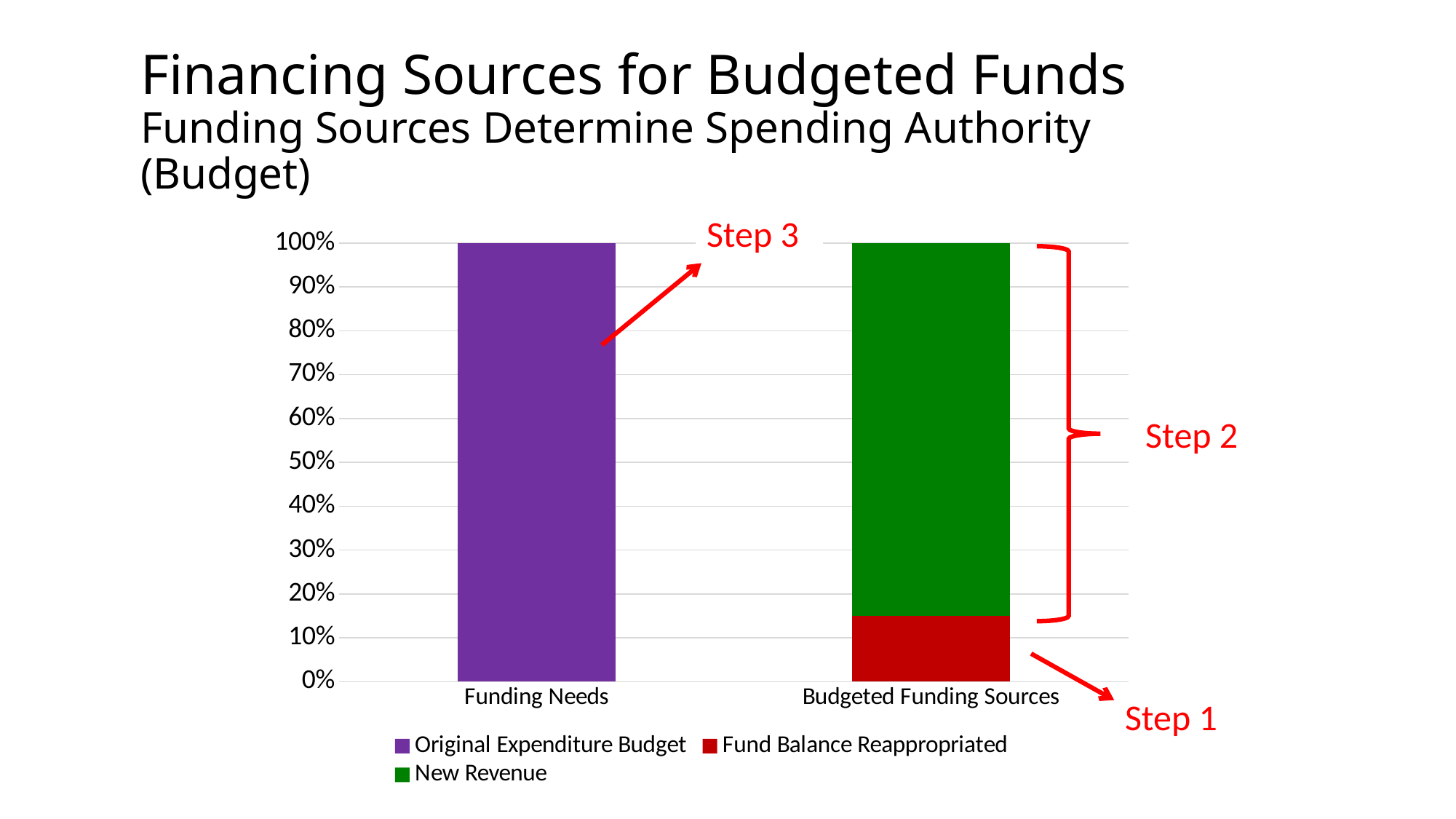
What is the total height of the stacked bar for Budgeted Funding Sources? 100% Is the value for Fund Balance Reappropriated in the Budgeted Funding Sources bar greater or less than 20%? less How many categories are shown on the x axis of the chart? 2 What kind of chart is shown on the slide? stacked bar chart Is the New Revenue portion of the Budgeted Funding Sources bar greater or less than 50%? greater In the Budgeted Funding Sources bar, which is larger: New Revenue or Fund Balance Reappropriated? New Revenue Is the value for Fund Balance Reappropriated in the Budgeted Funding Sources bar greater or less than 10%? greater Which series is shown in green in the chart? New Revenue Which series is shown in purple in the chart? Original Expenditure Budget What value does the Original Expenditure Budget bar for Funding Needs reach? 100% How many series does the chart's legend list? 3 Which category's bar contains the Fund Balance Reappropriated series? Budgeted Funding Sources